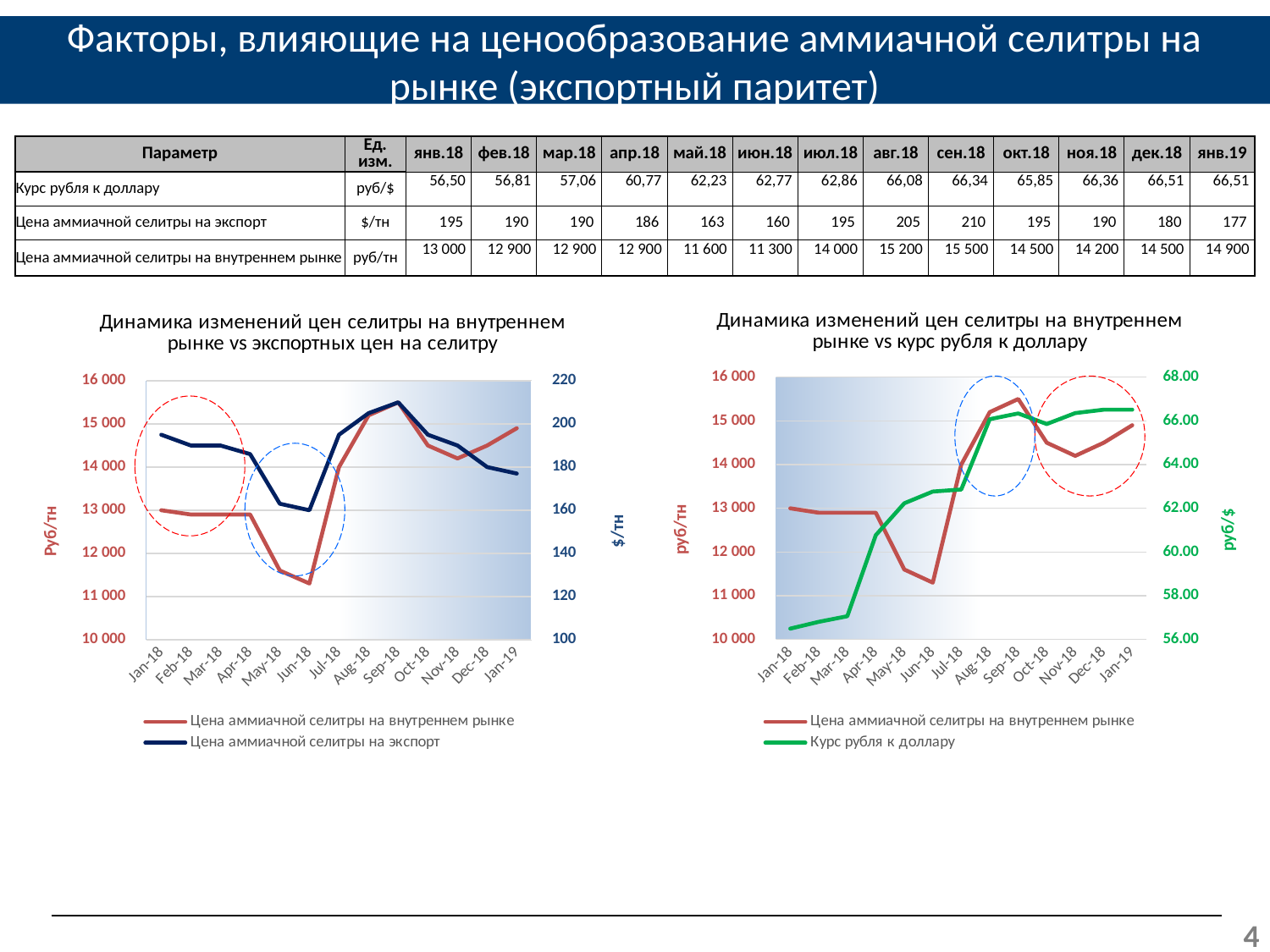
How many series does the legend of the right chart, 'Динамика изменений цен селитры на внутреннем рынке vs курс рубля к доллару', list? 2 How many months are plotted along the x axis of the left chart? 13 In the left chart, in which month is 'Цена аммиачной селитры на экспорт' at its lowest? Jun-18 In the right chart, which is higher for 'Курс рубля к доллару': Jan-18 or Jan-19? Jan-19 What is the value of 'Цена аммиачной селитры на внутреннем рынке' for сен.18 (Sep-18)? 15 500 In the left chart, is the value of 'Цена аммиачной селитры на экспорт' for Sep-18 greater or less than 200? greater What kind of chart is the left chart, 'Динамика изменений цен селитры на внутреннем рынке vs экспортных цен на селитру'? Line chart In the right chart, is the value of 'Курс рубля к доллару' for Mar-18 greater or less than 58.00? less In the left chart, in which month does 'Цена аммиачной селитры на внутреннем рынке' reach its highest value? Sep-18 In the right chart, does 'Курс рубля к доллару' generally rise or fall from Jan-18 to Sep-18? Rise What is the difference between 'Цена аммиачной селитры на внутреннем рынке' in сен.18 (15 500) and июн.18 (11 300)? 4 200 In the left chart, is the value of 'Цена аммиачной селитры на внутреннем рынке' for Jun-18 greater or less than 12 000? less